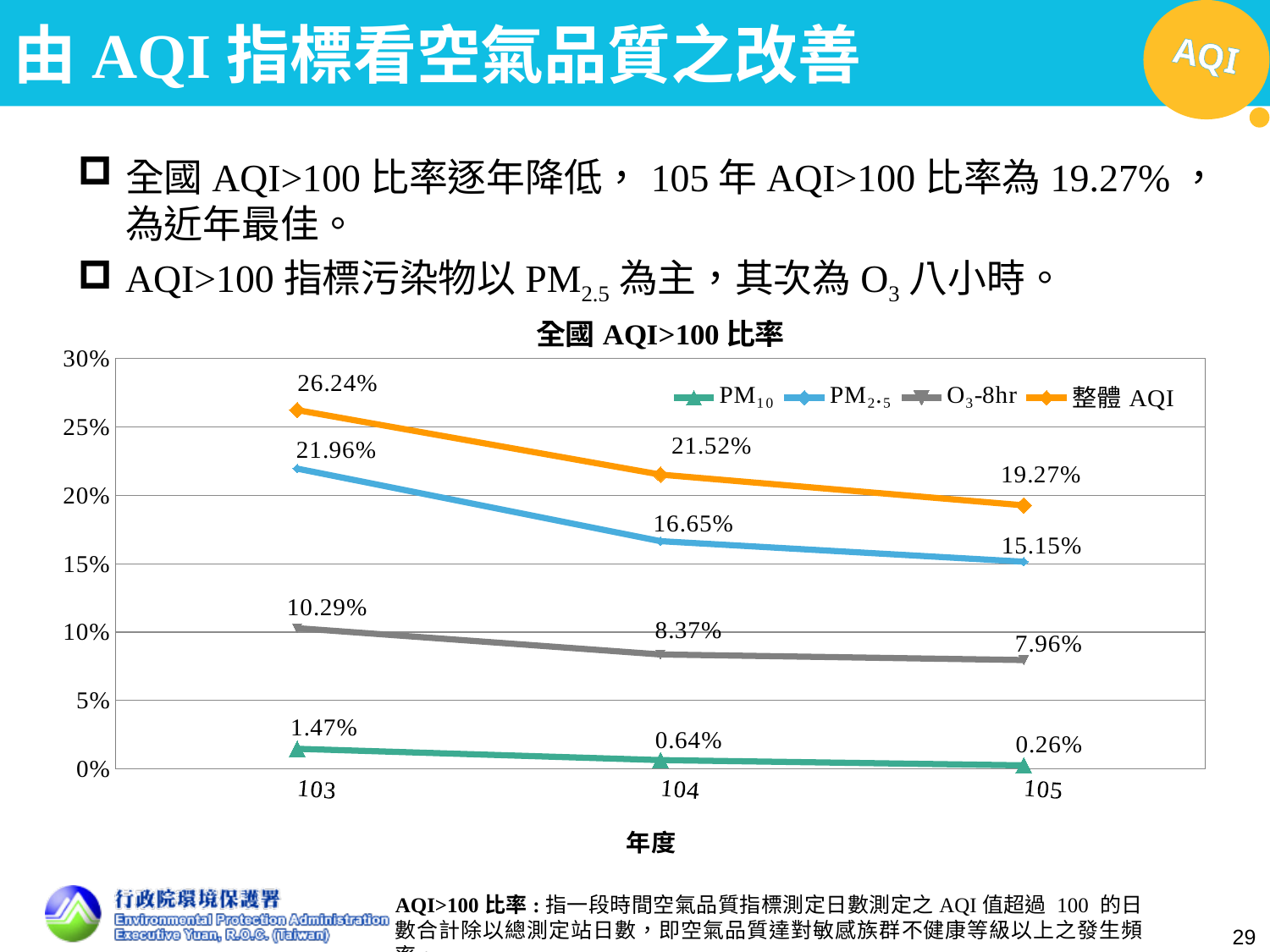
How many years are shown on the x axis? 3 What is the O3-8hr value for year 103? 10.29% What is the 整體 AQI value for year 105? 19.27% Which is larger in year 105: the PM2.5 value or the O3-8hr value? PM2.5 Which series has the lowest value in year 104? PM10 In which year is the 整體 AQI value highest? 103 What is the PM10 value for year 105? 0.26% How many series does the legend list? 4 What is the PM2.5 value for year 104? 16.65% What is the difference between the 整體 AQI values for years 103 and 105? 6.97% Does the PM2.5 series rise or fall from year 103 to year 105? fall What type of chart is shown on the slide? line chart